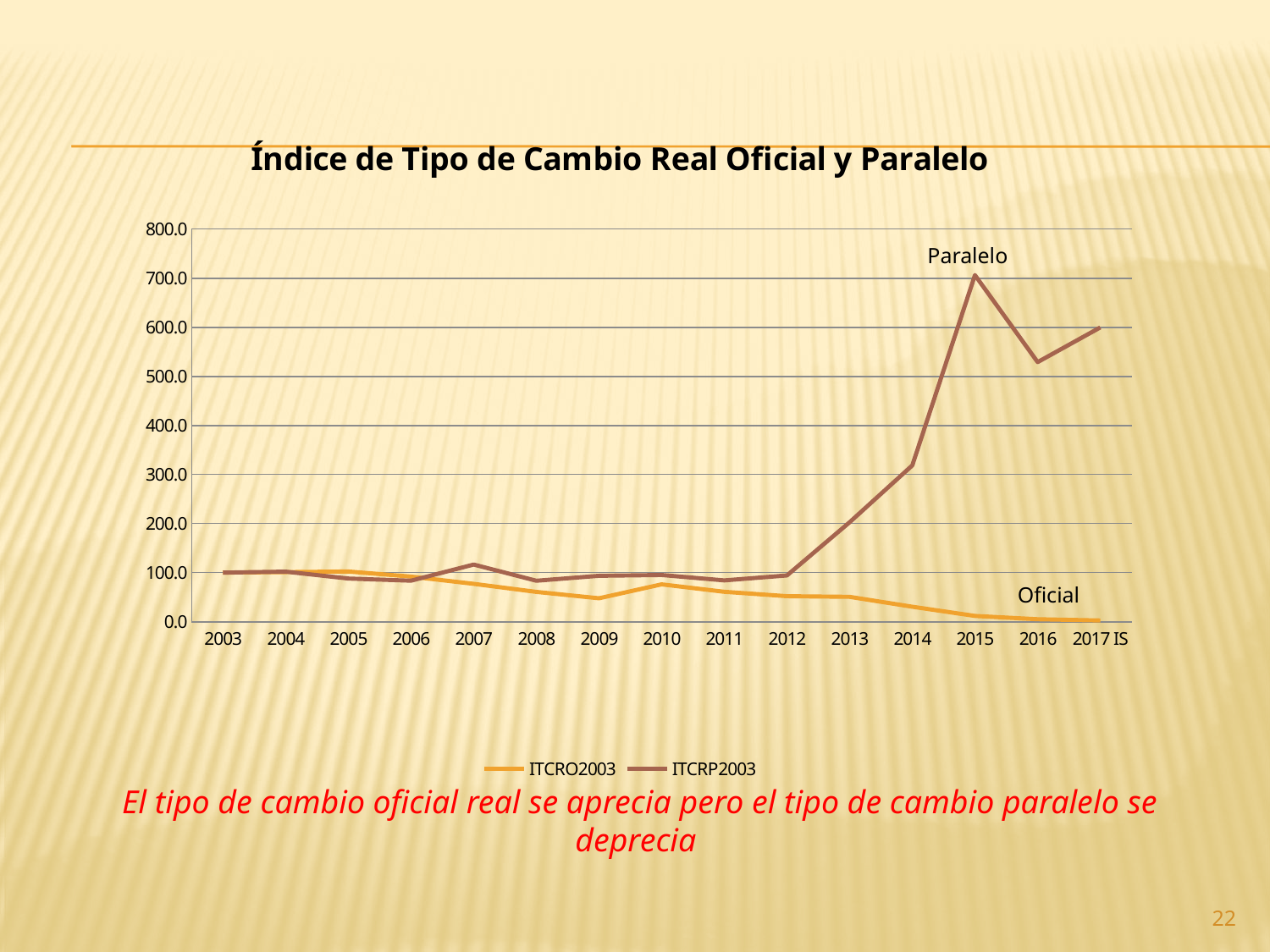
Is the value of the Paralelo (ITCRP2003) series in 2015 greater or less than 600.0? greater What kind of chart is shown on the slide? Line chart In which year does the Paralelo (ITCRP2003) series reach its highest value? 2015 Is the value of the Paralelo (ITCRP2003) series in 2016 greater or less than 400.0? greater Is the value of the Oficial (ITCRO2003) series in 2016 greater or less than 100.0? less What are the two series names shown in the legend? ITCRO2003 and ITCRP2003 How many series does the legend list? 2 Which series has the larger value in 2015, ITCRO2003 or ITCRP2003? ITCRP2003 What is the title of the chart? Índice de Tipo de Cambio Real Oficial y Paralelo How many points are plotted along the x axis for each series? 15 Does the Oficial (ITCRO2003) series rise or fall overall from 2003 to 2017 IS? Fall